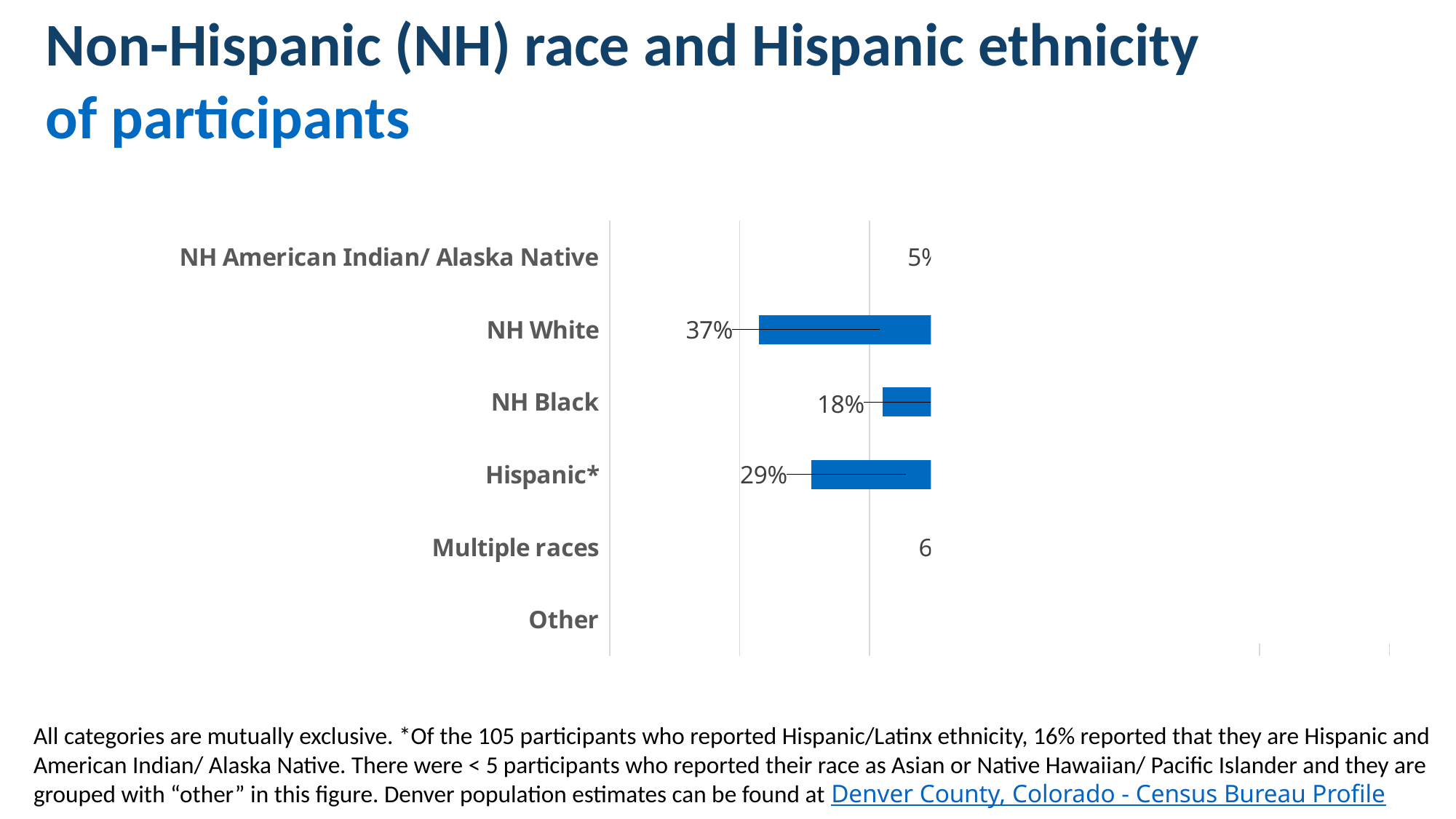
What kind of chart is shown on the slide? Bar chart What percentage of participants are Hispanic*? 29% What is the title of the slide? Non-Hispanic (NH) race and Hispanic ethnicity of participants What percentage of participants are NH Black? 18% What is the difference in percentage points between Hispanic* and NH Black participants? 11 How many categories are listed on the chart's vertical axis? 6 What is the difference in percentage points between NH White and NH Black participants? 19 What is the difference in percentage points between NH White and Hispanic* participants? 8 Which category has the highest percentage of participants? NH White Which is larger, the percentage for NH Black or for Hispanic*? Hispanic* Which is larger, the percentage for NH White or for Hispanic*? NH White What percentage of participants are NH White? 37%